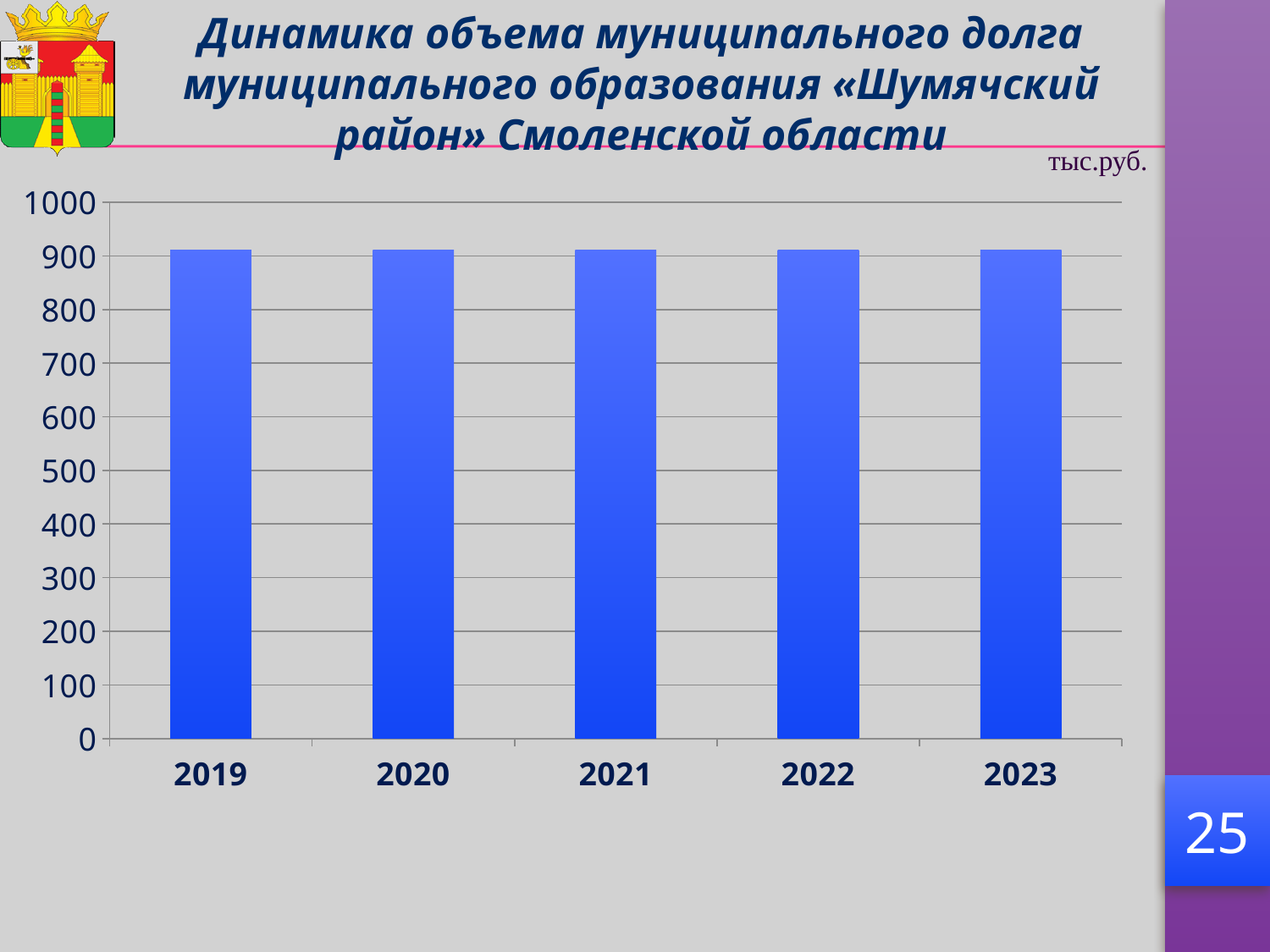
Is the value for 2019 greater or less than 800? greater What kind of chart is shown on the slide? bar chart How many years are shown on the x axis of the chart? 5 Is the value for 2022 greater or less than 700? greater What unit of measurement is indicated above the chart? тыс.руб. Is the value for 2021 greater or less than 1000? less Do the values rise, fall, or stay the same from 2019 to 2023? stay the same What is the first year shown on the x axis? 2019 What is the highest value shown on the y axis? 1000